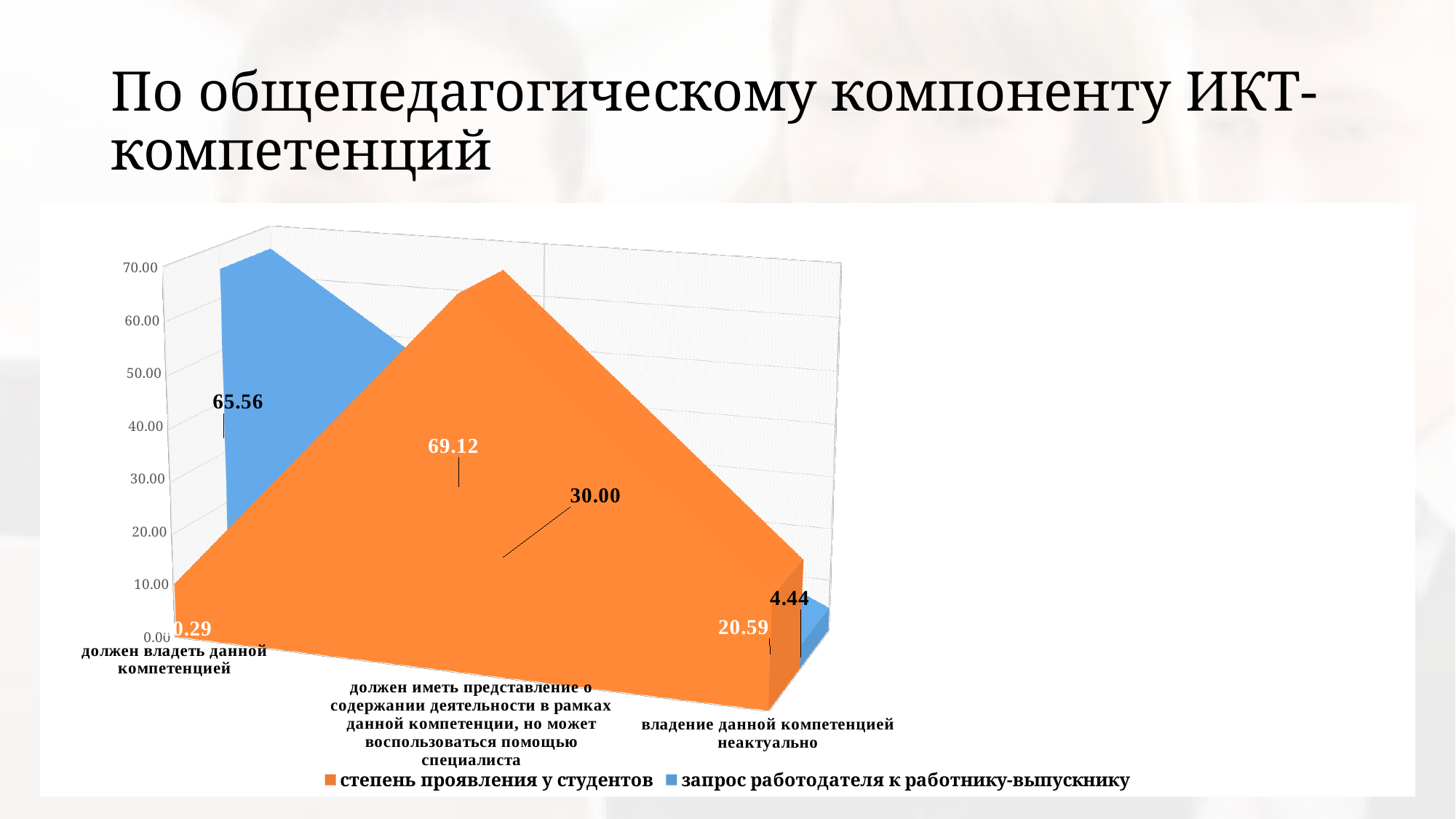
What is the value of the series 'запрос работодателя к работнику-выпускнику' for the category 'должен владеть данной компетенцией'? 65.56 For the series 'запрос работодателя к работнику-выпускнику', which category has the highest value? должен владеть данной компетенцией What is the value of the series 'запрос работодателя к работнику-выпускнику' for the category 'владение данной компетенцией неактуально'? 4.44 How many series does the chart legend list? 2 What kind of chart is shown on the slide? area chart What is the value of the series 'запрос работодателя к работнику-выпускнику' for the category 'должен иметь представление о содержании деятельности в рамках данной компетенции, но может воспользоваться помощью специалиста'? 30.00 How many categories are shown on the x axis of the chart? 3 What is the value of the series 'степень проявления у студентов' for the category 'должен иметь представление о содержании деятельности в рамках данной компетенции, но может воспользоваться помощью специалиста'? 69.12 For the series 'запрос работодателя к работнику-выпускнику', which category has the lowest value? владение данной компетенцией неактуально For the category 'должен иметь представление о содержании деятельности в рамках данной компетенции, но может воспользоваться помощью специалиста', which series has the larger value? степень проявления у студентов What is the value of the series 'степень проявления у студентов' for the category 'владение данной компетенцией неактуально'? 20.59 For the category 'должен иметь представление о содержании деятельности в рамках данной компетенции, но может воспользоваться помощью специалиста', what is the difference between the 'степень проявления у студентов' value and the 'запрос работодателя к работнику-выпускнику' value? 39.12